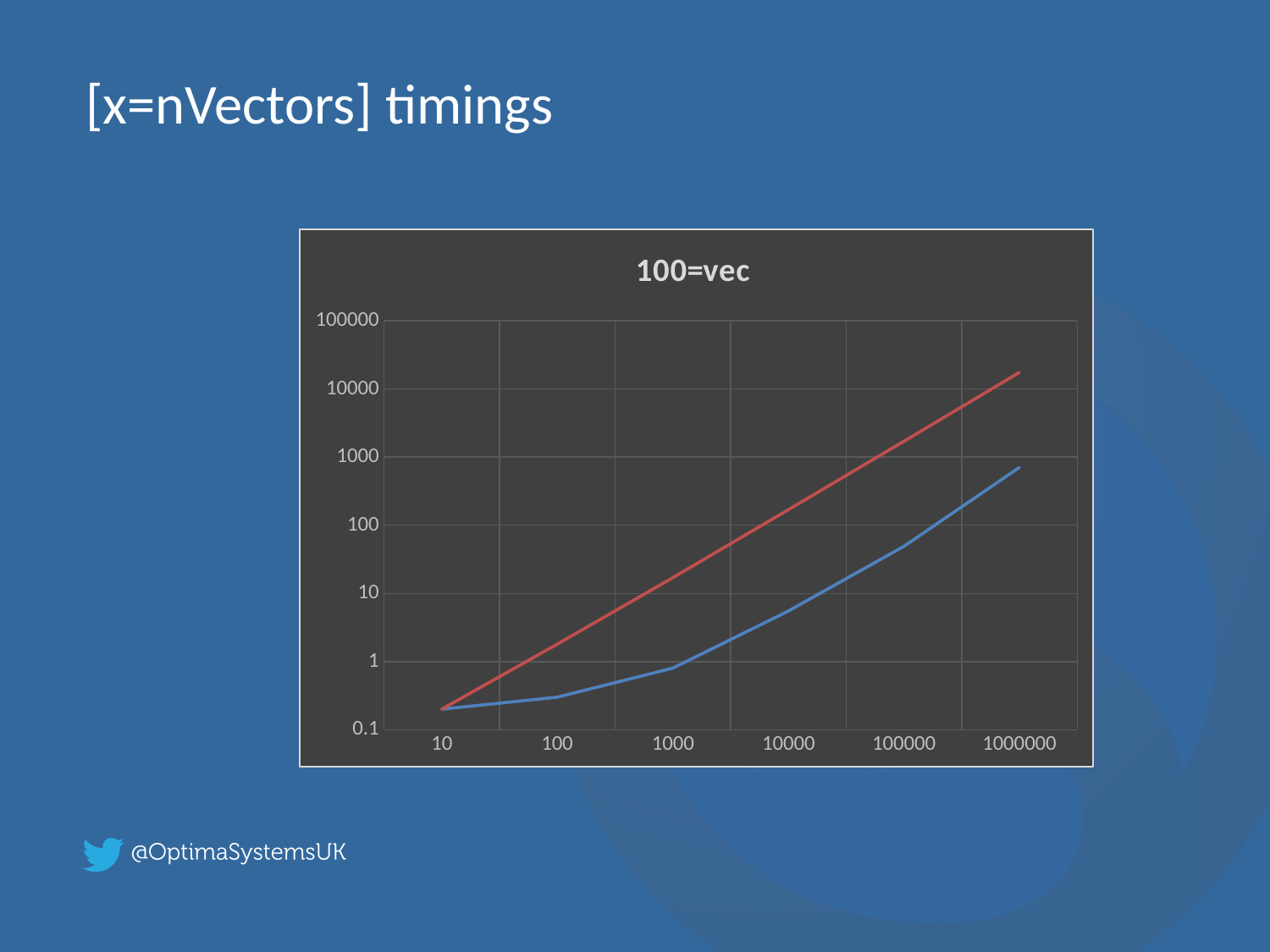
How many x-axis tick labels are shown on the chart? 6 At x = 1000000, which line has the higher value, the red line or the blue line? red line Is the value of the red line at x = 100000 greater or less than 1000? greater How many lines are plotted on the chart? 2 What is the title of the chart? 100=vec Is the value of the red line at x = 1000000 greater or less than 10000? greater Do the values of the red line rise or fall as the x axis increases? rise Is the value of the blue line at x = 1000000 greater or less than 1000? less What kind of chart is shown on the slide? line chart Do the values of the blue line rise or fall as the x axis increases? rise